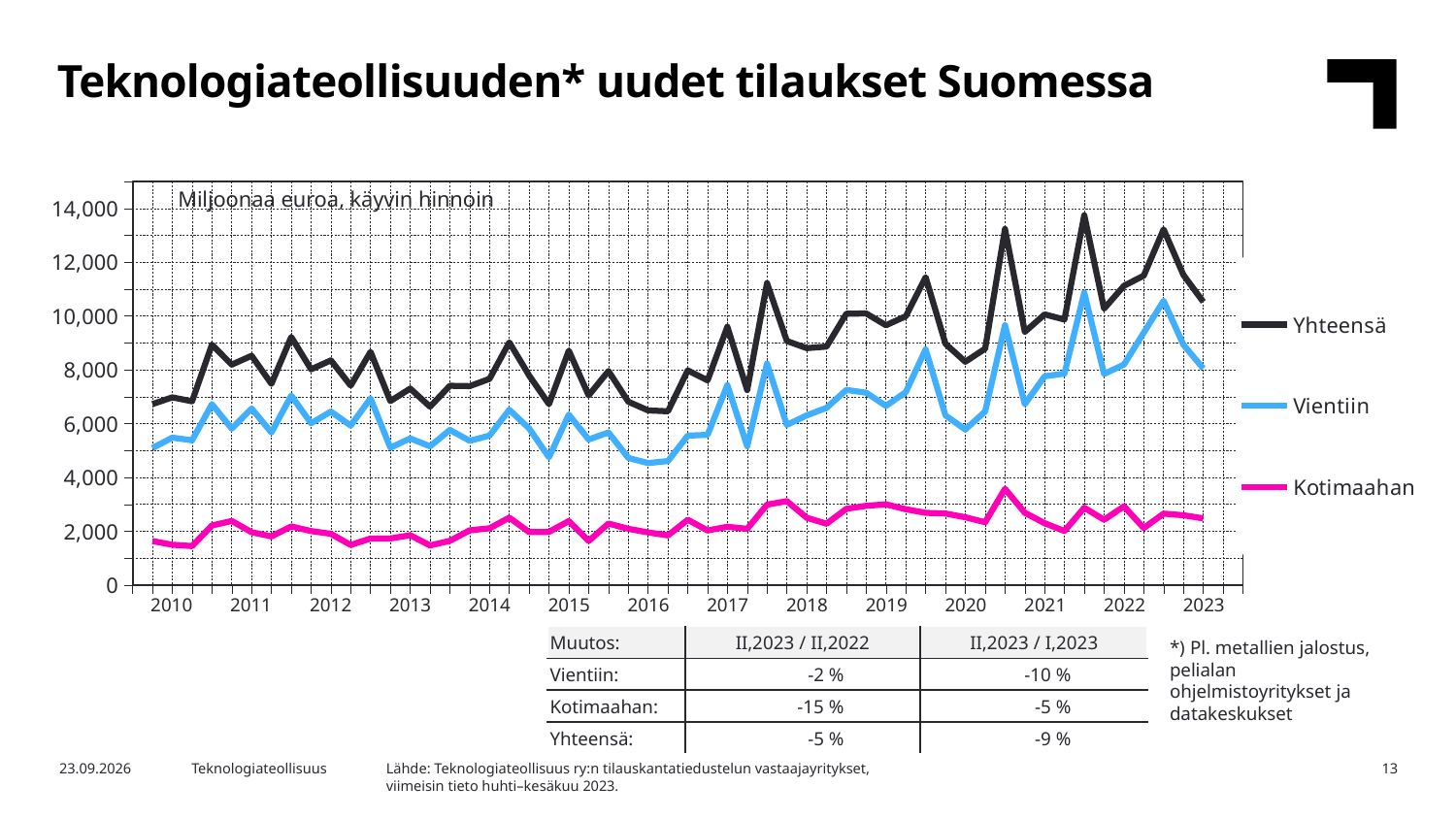
What kind of chart is shown on the slide? line chart Which series is larger in 2018, Vientiin or Kotimaahan? Vientiin What unit label is printed inside the chart area? Miljoonaa euroa, käyvin hinnoin How many series does the chart legend list? 3 Which series has the highest values throughout the chart? Yhteensä Is the highest value of the Kotimaahan series greater or less than 4,000? less Is the peak value of the Yhteensä series in 2021 greater or less than 12,000? greater What are the three series named in the chart legend? Yhteensä, Vientiin, Kotimaahan Is the last value of the Yhteensä series in 2023 greater or less than 10,000? greater Does the Yhteensä series overall rise or fall from 2010 to 2023? rise Which series has the lowest values throughout the chart? Kotimaahan